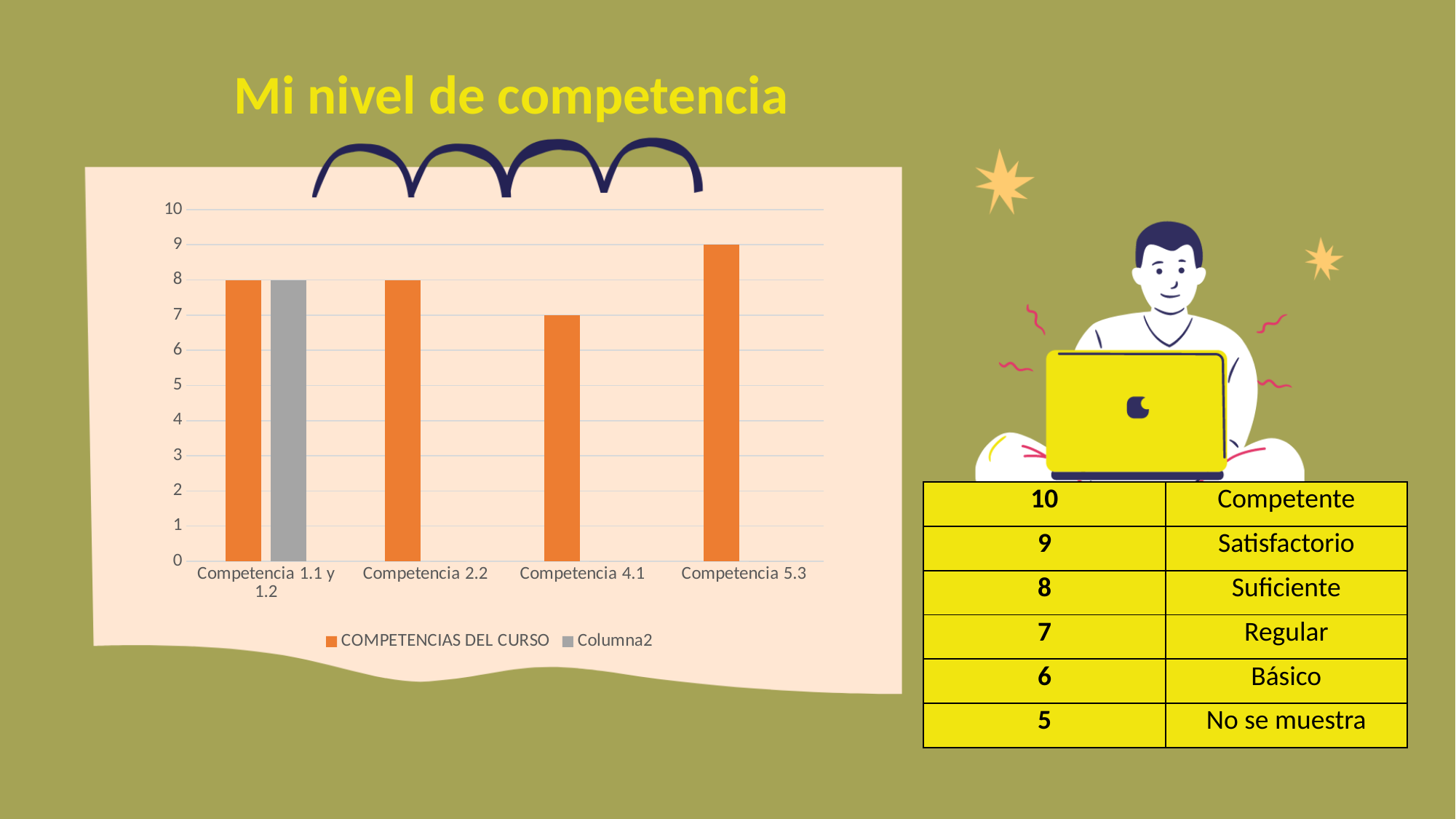
Which category has the lowest value for COMPETENCIAS DEL CURSO? Competencia 4.1 What is the difference between the COMPETENCIAS DEL CURSO values for Competencia 5.3 and Competencia 4.1? 2 Which category has the highest value for COMPETENCIAS DEL CURSO? Competencia 5.3 What is the value of the Columna2 series for Competencia 1.1 y 1.2? 8 What is the value of COMPETENCIAS DEL CURSO for Competencia 2.2? 8 What is the title of the slide containing the chart? Mi nivel de competencia How many series does the chart legend list? 2 What is the value of COMPETENCIAS DEL CURSO for Competencia 4.1? 7 What type of chart is shown on the slide? bar chart How many categories are shown on the x axis of the chart? 4 Which is larger, the COMPETENCIAS DEL CURSO value for Competencia 2.2 or for Competencia 4.1? Competencia 2.2 What is the value of COMPETENCIAS DEL CURSO for Competencia 5.3? 9